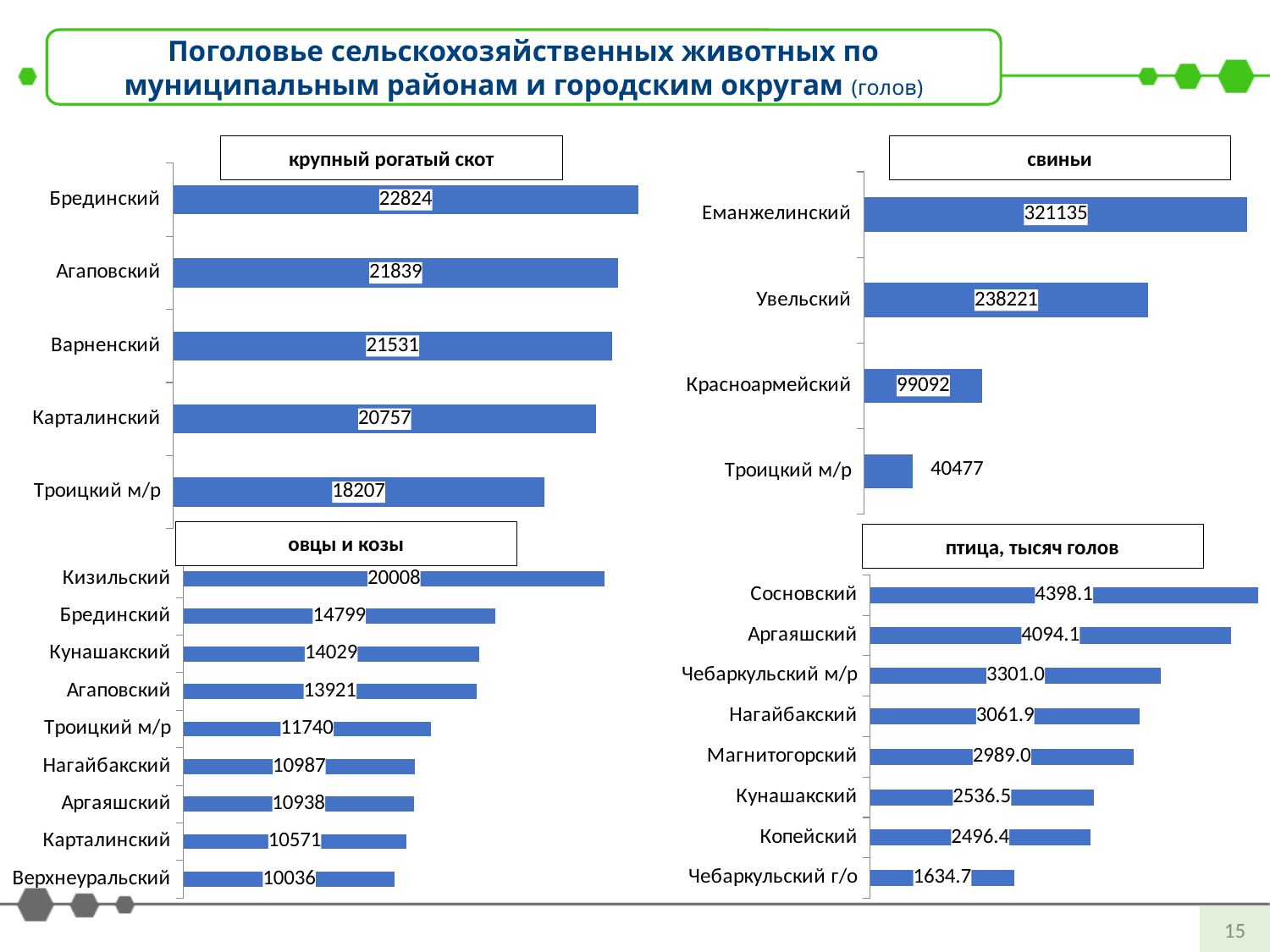
In the 'овцы и козы' chart, which is larger, Нагайбакский or Карталинский? Нагайбакский In the 'свиньи' chart, which district has the lowest value? Троицкий м/р In the 'свиньи' chart, what is the value for Увельский? 238221 In the 'свиньи' chart, how many districts are shown? 4 In the 'овцы и козы' chart, what is the value for Кунашакский? 14029 In the 'крупный рогатый скот' chart, what is the value for Варненский? 21531 In the 'крупный рогатый скот' chart, which district has the highest value? Брединский In the 'овцы и козы' chart, how many districts are shown? 9 In the 'птица, тысяч голов' chart, what is the value for Магнитогорский? 2989.0 What type of chart is the 'птица, тысяч голов' chart? Bar chart In the 'птица, тысяч голов' chart, what is the difference between Сосновский and Аргаяшский? 304.0 In the 'крупный рогатый скот' chart, what is the difference between Брединский and Троицкий м/р? 4617